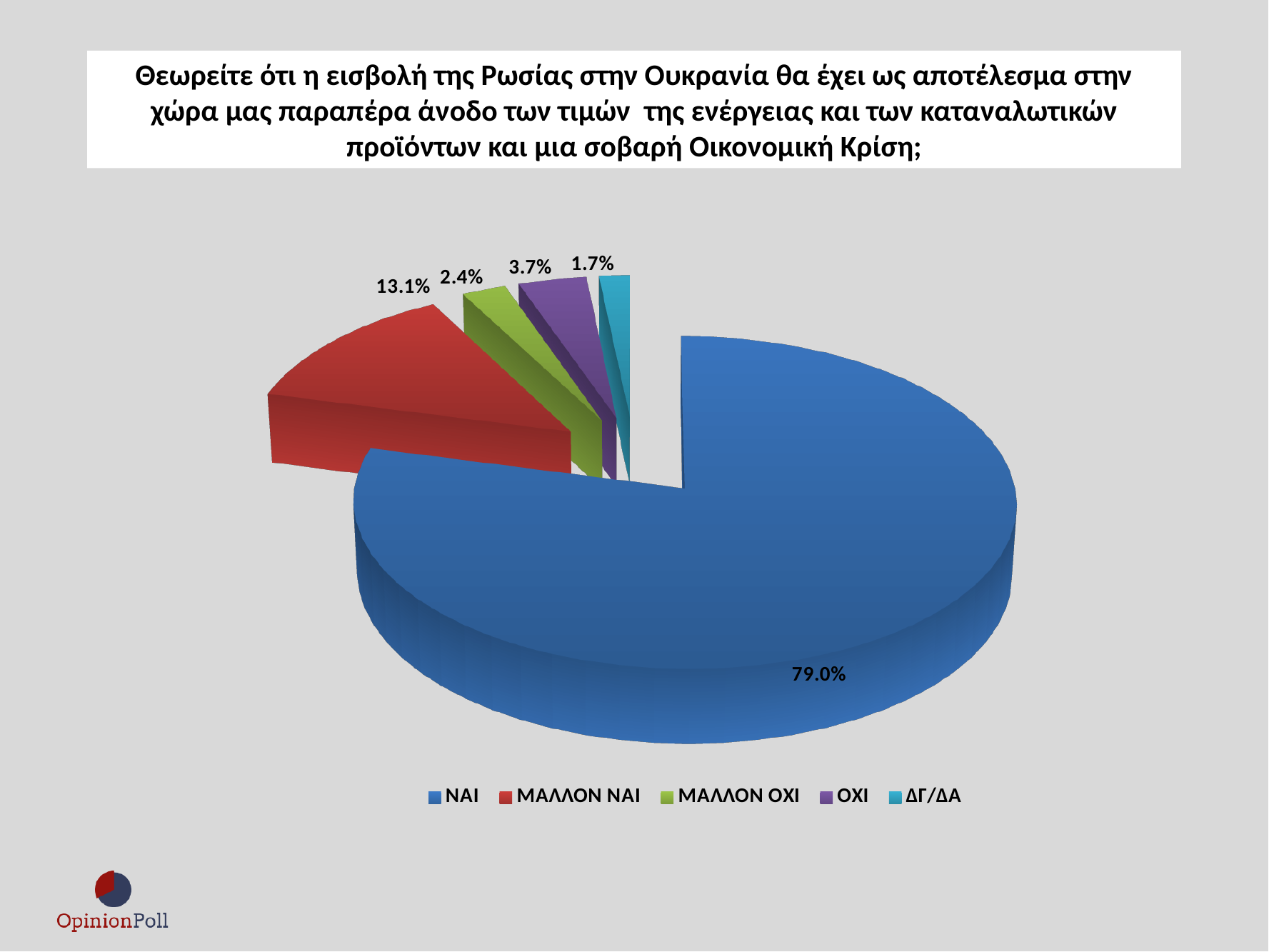
Which response has the largest share of the pie? ΝΑΙ What percentage of respondents answered ΜΑΛΛΟΝ ΝΑΙ? 13.1% What is the difference in percentage points between ΝΑΙ and ΜΑΛΛΟΝ ΝΑΙ? 65.9 What percentage of respondents answered ΜΑΛΛΟΝ ΟΧΙ? 2.4% How many slices does the pie chart have? 5 What percentage of respondents answered ΟΧΙ? 3.7% Which is larger, the share for ΟΧΙ or the share for ΜΑΛΛΟΝ ΟΧΙ? ΟΧΙ Which colour represents ΜΑΛΛΟΝ ΝΑΙ in the legend? Red What kind of chart is shown on the slide? Pie chart Which response has the smallest share of the pie? ΔΓ/ΔΑ What percentage of respondents answered ΔΓ/ΔΑ? 1.7% What percentage of respondents answered ΝΑΙ? 79.0%